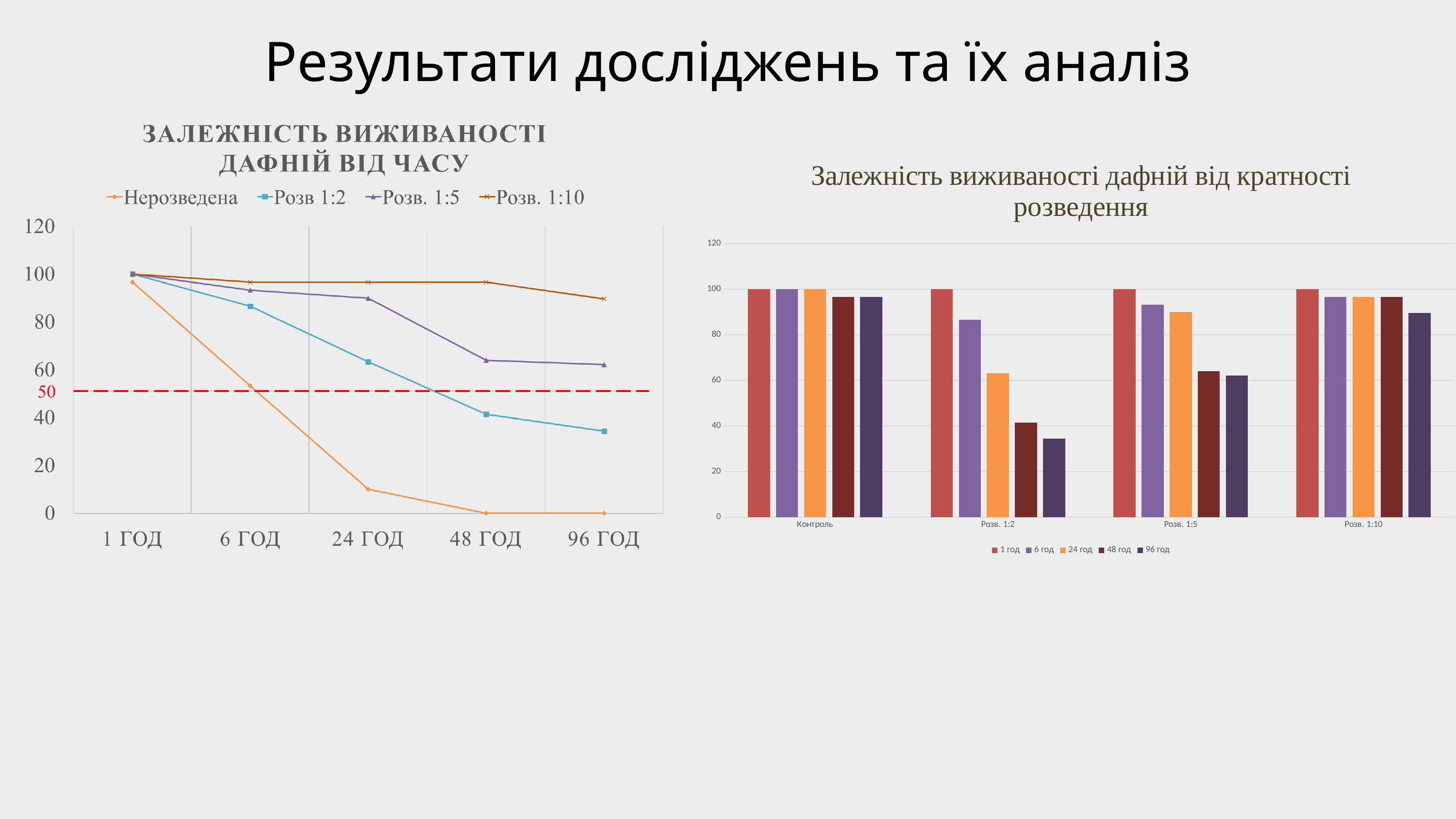
How many time points are shown on the x axis of the left line chart? 5 What kind of chart is the left chart, 'ЗАЛЕЖНІСТЬ ВИЖИВАНОСТІ ДАФНІЙ ВІД ЧАСУ'? Line chart In the left line chart, which series has the lowest value at 24 ГОД? Нерозведена In the left line chart, what is the value of 'Нерозведена' at 96 ГОД? 0 In the left line chart, is the value of 'Розв 1:2' at 48 ГОД greater or less than 60? less How many categories are shown on the x axis of the right bar chart? 4 In the right bar chart, is the '96 год' bar for 'Розв. 1:2' greater or less than 40? less In the left line chart, does the 'Нерозведена' series rise or fall from 1 ГОД to 96 ГОД? Fall In the left line chart, which series has the highest value at 96 ГОД? Розв. 1:10 How many series does the legend of the right bar chart list? 5 How many series does the legend of the left line chart list? 4 What kind of chart is the right chart, 'Залежність виживаності дафній від кратності розведення'? Bar chart